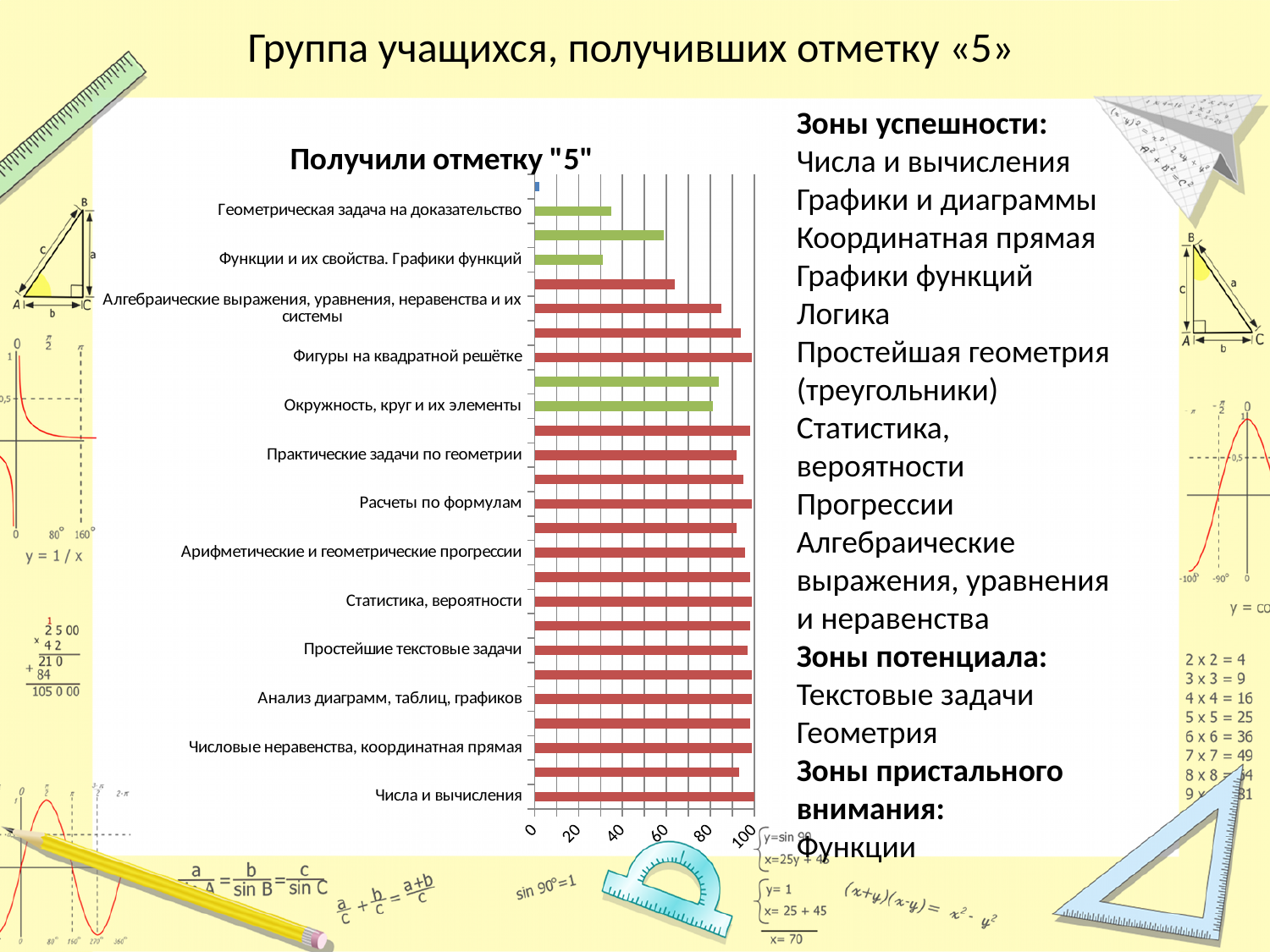
Is the value for Практические задачи по геометрии greater or less than 80? greater Is the value for Окружность, круг и их элементы greater or less than 60? greater Is the value for Функции и их свойства. Графики функций greater or less than 40? less Which has the larger value: Геометрическая задача на доказательство or Алгебраические выражения, уравнения, неравенства и их системы? Алгебраические выражения, уравнения, неравенства и их системы What kind of chart is shown on the slide? bar chart What is the title of the chart? Получили отметку "5" Which has the larger value: Расчеты по формулам or Функции и их свойства. Графики функций? Расчеты по формулам What is the highest value shown on the horizontal axis of the chart? 100 Which has the larger value: Числа и вычисления or Функции и их свойства. Графики функций? Числа и вычисления